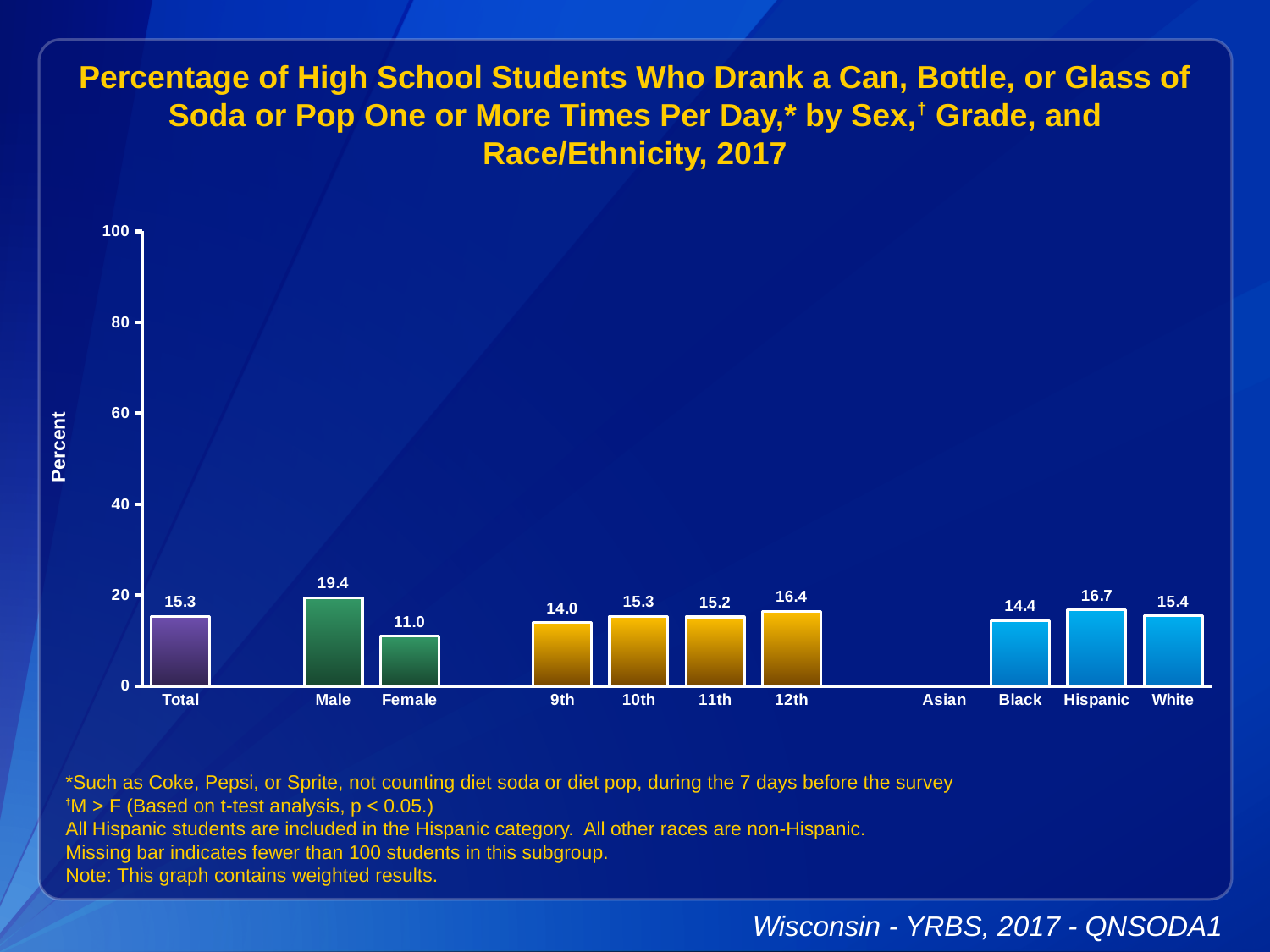
What is the difference between the Male and Female values? 8.4 Which category has no bar shown? Asian What kind of chart is shown? bar chart What is the value for Hispanic? 16.7 What is the value for Male? 19.4 Which is larger, the value for 9th grade or the value for 12th grade? 12th What is the value for 12th grade? 16.4 How many bars are plotted on the chart? 10 Which category has the lowest value among the bars shown? Female Which category has the highest value? Male Is the value for Total greater or less than 20? less What is the value for Female? 11.0